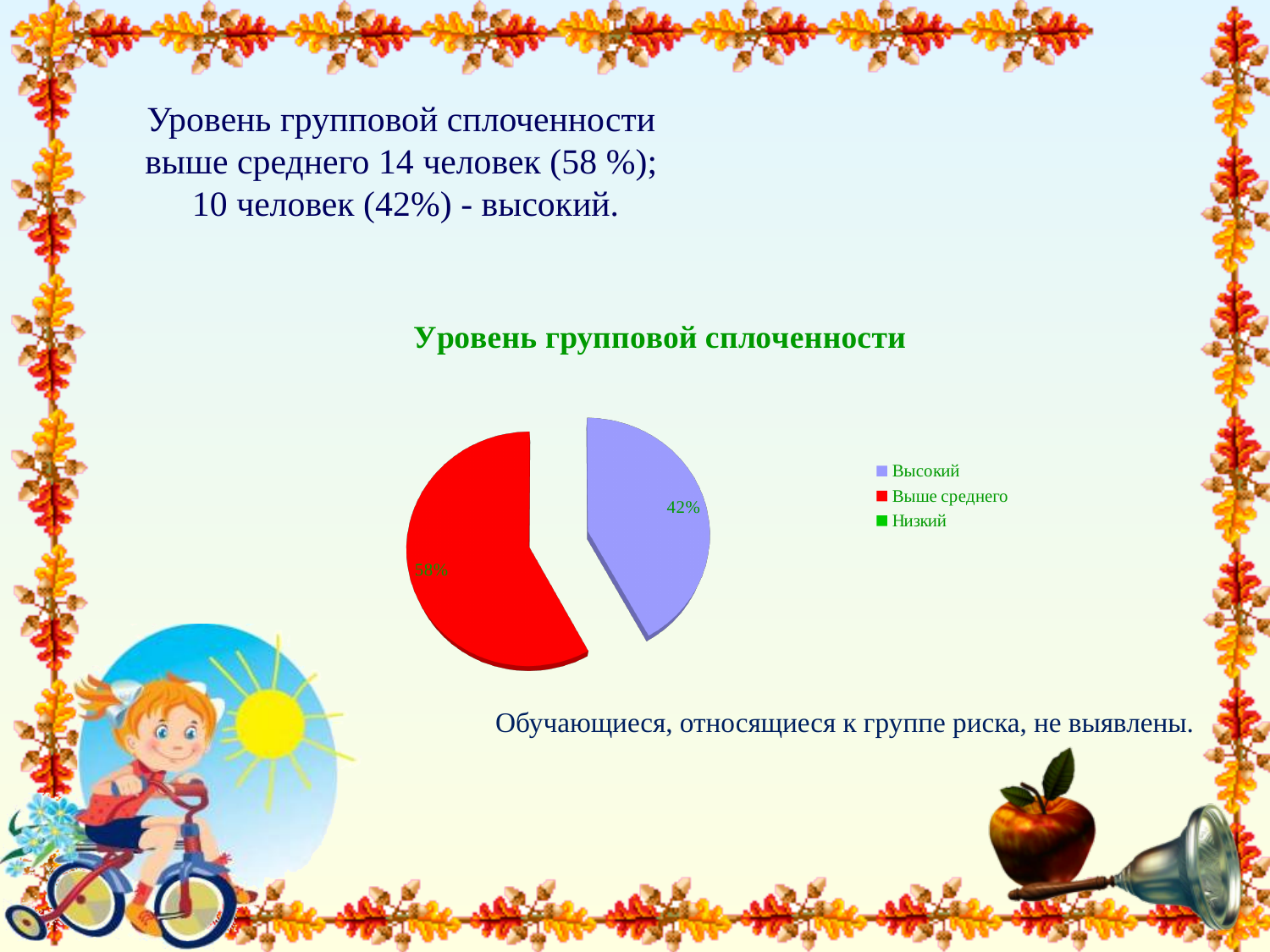
Which of the two visible slices is larger, "Высокий" or "Выше среднего"? Выше среднего What is the title of the chart? Уровень групповой сплоченности Which legend category has no visible slice in the pie? Низкий What is the difference in percentage points between the "Выше среднего" and "Высокий" slices? 16 Is the share for "Высокий" greater or less than 50%? less What colour is the "Высокий" slice? blue What share of the pie does the "Выше среднего" slice represent? 58% What kind of chart is shown on the slide? pie chart How many slices are visibly drawn in the pie? 2 How many entries does the chart legend list? 3 What share of the pie does the "Высокий" slice represent? 42% Which category has the largest slice of the pie? Выше среднего